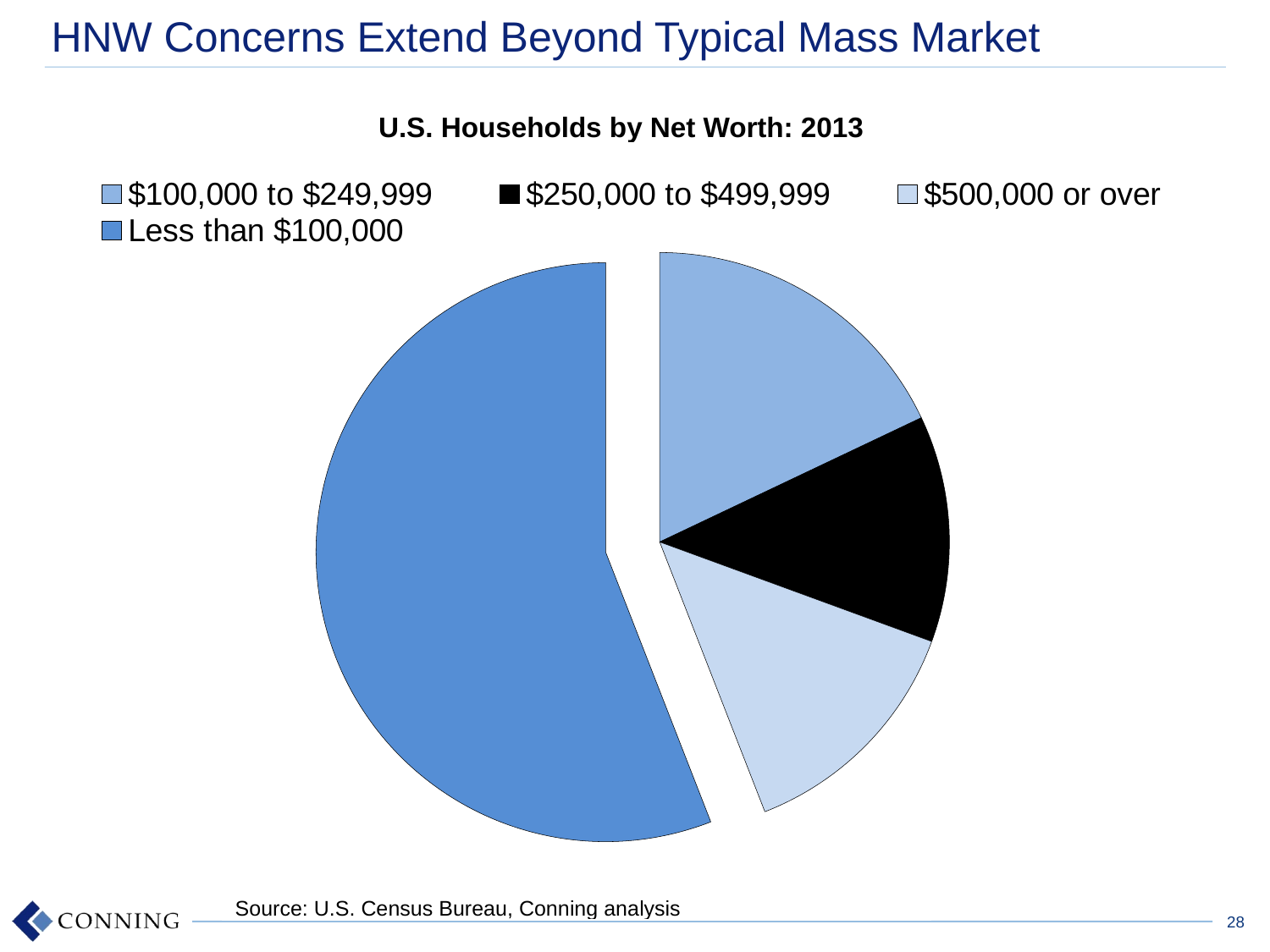
Which slice is larger: "Less than $100,000" or "$100,000 to $249,999"? Less than $100,000 Which net worth category is shown in black on the pie chart? $250,000 to $499,999 What is the title of the chart? U.S. Households by Net Worth: 2013 How many entries does the legend list? 4 Which slice is larger: "Less than $100,000" or "$250,000 to $499,999"? Less than $100,000 What kind of chart is shown on the slide? pie chart Which net worth category has the largest slice of the pie? Less than $100,000 How many categories does the pie chart show? 4 Which slice is larger: "Less than $100,000" or "$500,000 or over"? Less than $100,000